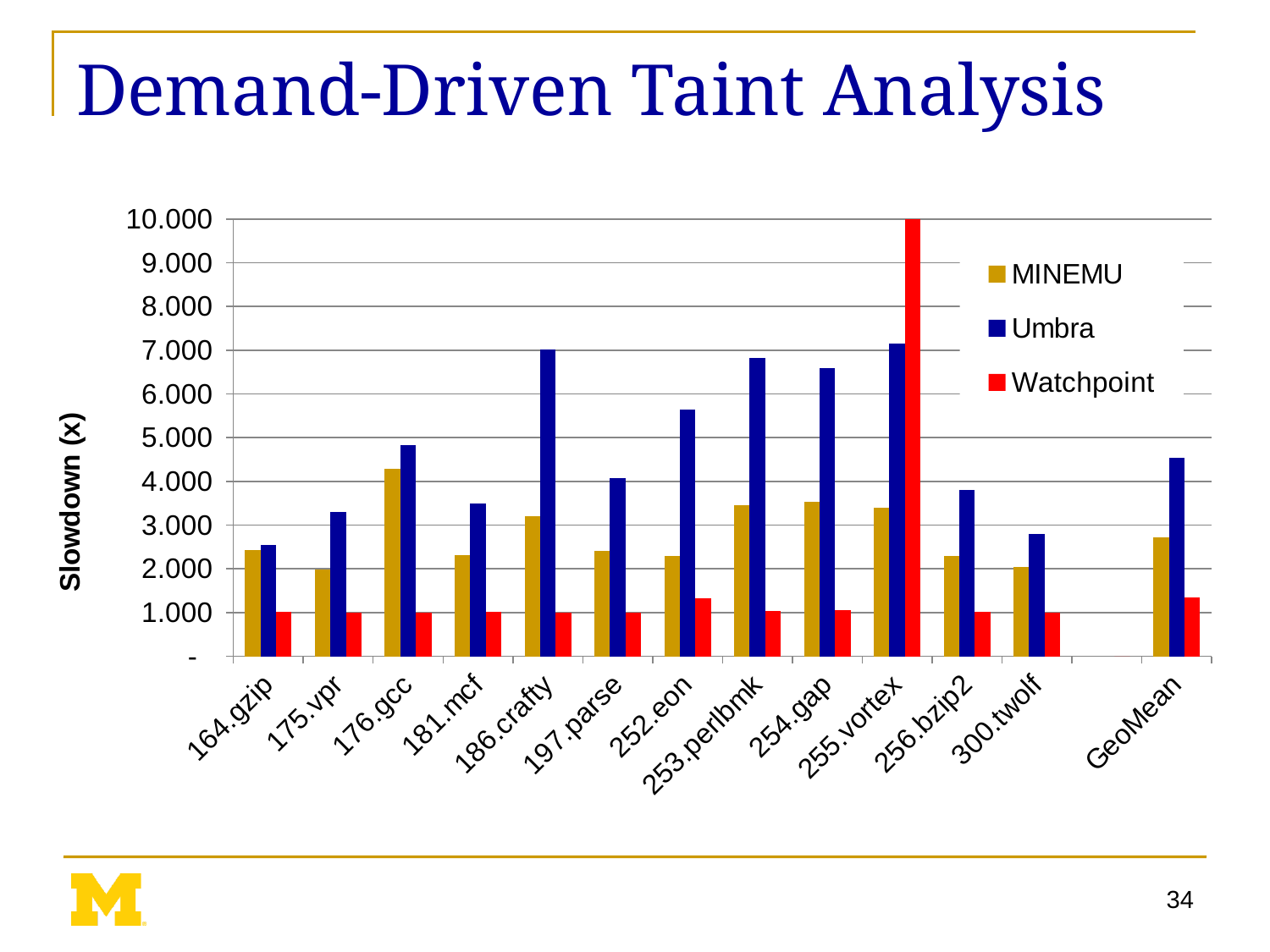
How many categories are shown along the x axis? 13 For 252.eon, which is larger: the Umbra value or the MINEMU value? Umbra Is the Watchpoint value for 255.vortex greater or less than 9.000? greater Which series is shown in red? Watchpoint Is the Umbra value for GeoMean greater or less than 4.000? greater How many series does the legend list? 3 Is the Umbra value for 186.crafty greater or less than 6.000? greater What kind of chart is shown on the slide? bar chart Which category has the highest Watchpoint value? 255.vortex What is the label of the y axis? Slowdown (x) Which category has the highest MINEMU value? 176.gcc